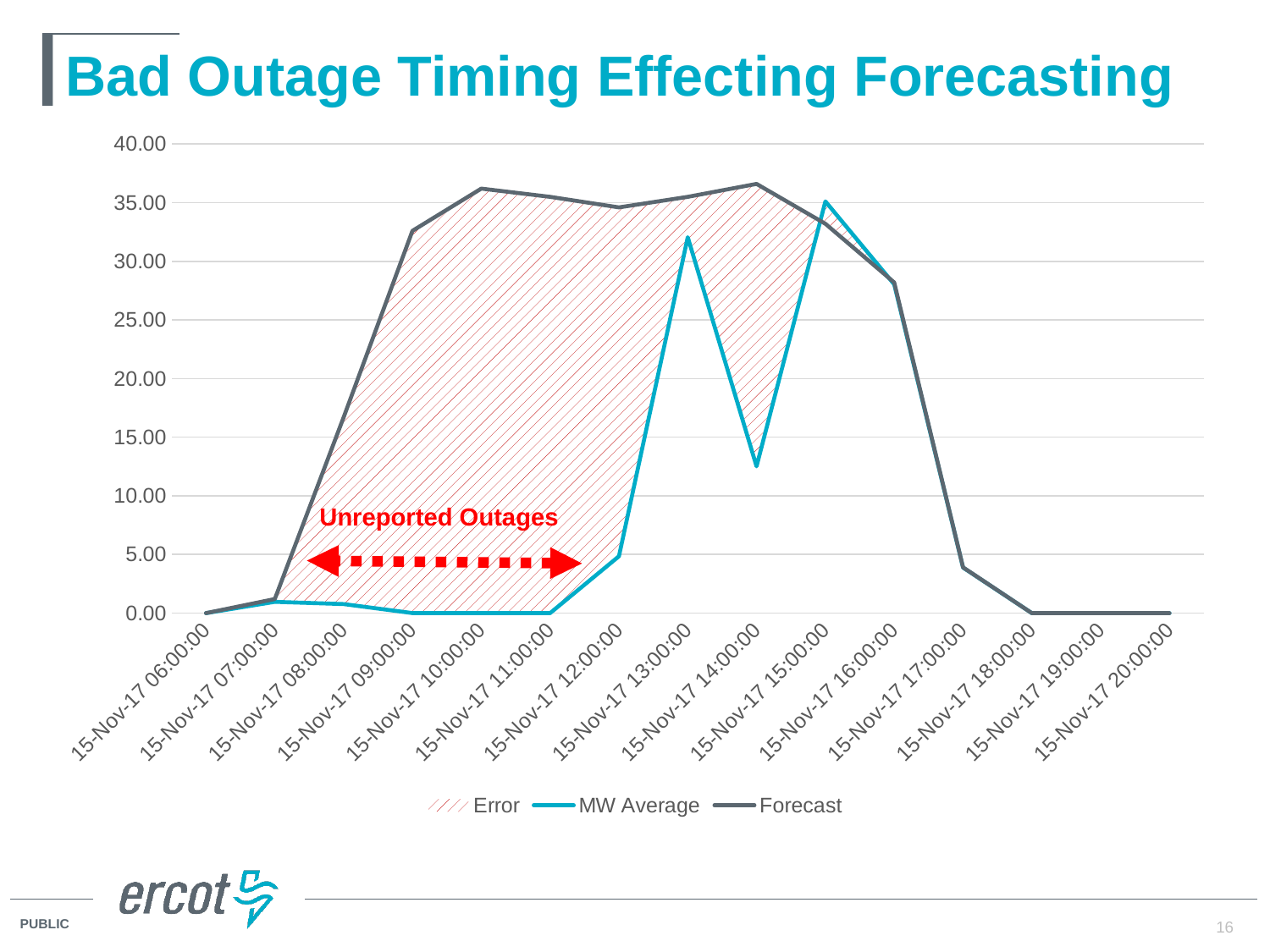
How many time points are plotted along the x axis? 15 How many series does the legend list? 3 Does the Forecast series rise or fall between 15-Nov-17 16:00:00 and 15-Nov-17 18:00:00? Fall At 15-Nov-17 14:00:00, which is larger, the Forecast or the MW Average? Forecast What kind of chart is shown on the slide? Line chart At which time does the MW Average series reach its highest value? 15-Nov-17 15:00:00 What is the title of the chart slide? Bad Outage Timing Effecting Forecasting Is the MW Average value at 15-Nov-17 14:00:00 greater or less than 15.00? less What does the red annotation text inside the hatched area say? Unreported Outages Is the MW Average value at 15-Nov-17 11:00:00 greater or less than 5.00? less Is the Forecast value at 15-Nov-17 10:00:00 greater or less than 30.00? greater